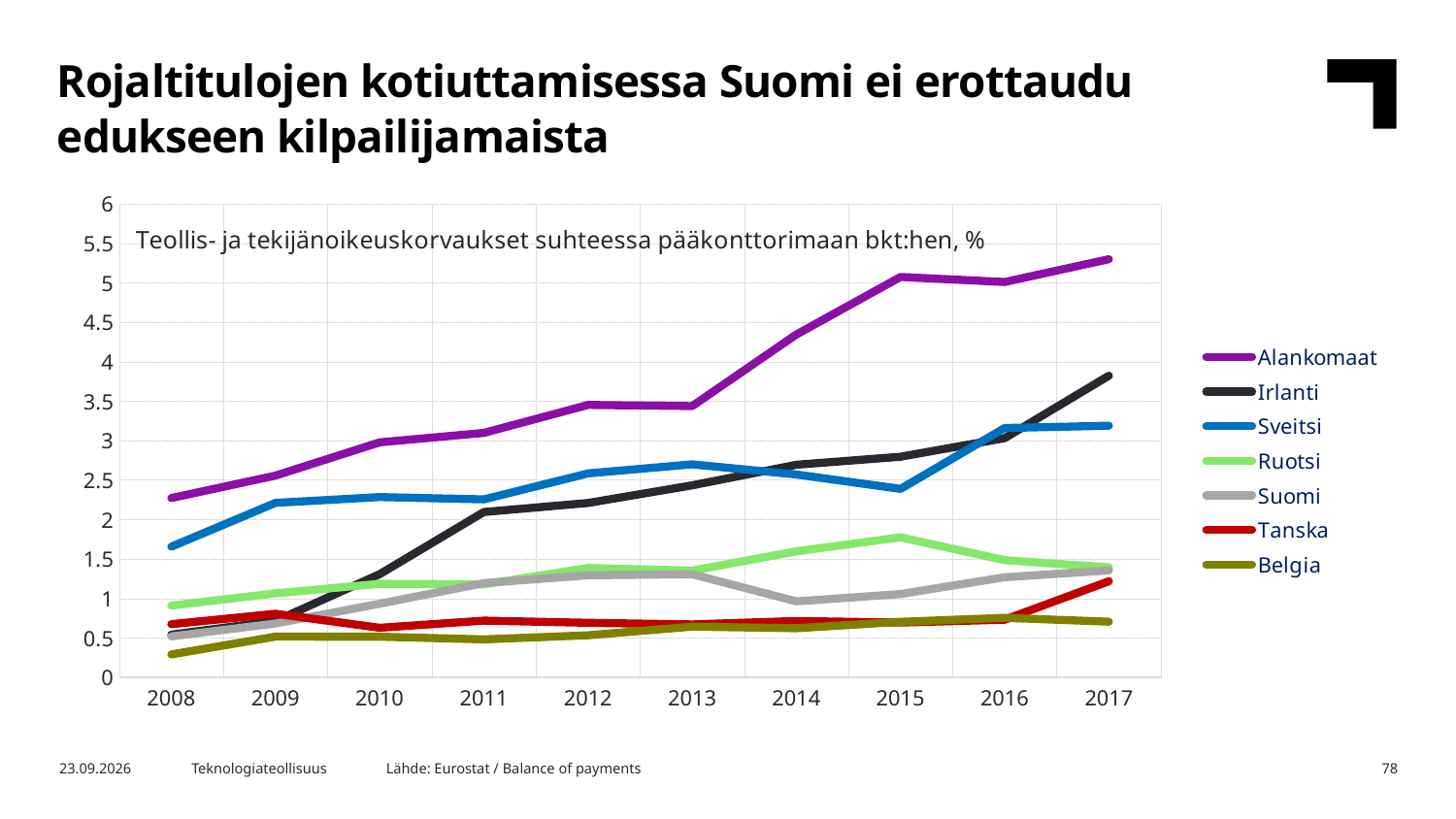
Which country has the lowest value in 2008? Belgia Is the value for Irlanti in 2017 greater or less than 3.5? greater What kind of chart is shown on the slide? line chart Which country has the highest value in 2017? Alankomaat What is the title printed inside the chart area? Teollis- ja tekijänoikeuskorvaukset suhteessa pääkonttorimaan bkt:hen, % Is the value for Alankomaat in 2017 greater or less than 5? greater Which country has the lowest value in 2017? Belgia How many series does the legend list? 7 In 2017, which is larger, the value for Irlanti or the value for Sveitsi? Irlanti How many years are shown on the x axis? 10 Does the value for Alankomaat rise or fall overall from 2008 to 2017? rise Is the value for Belgia in 2008 greater or less than 0.5? less